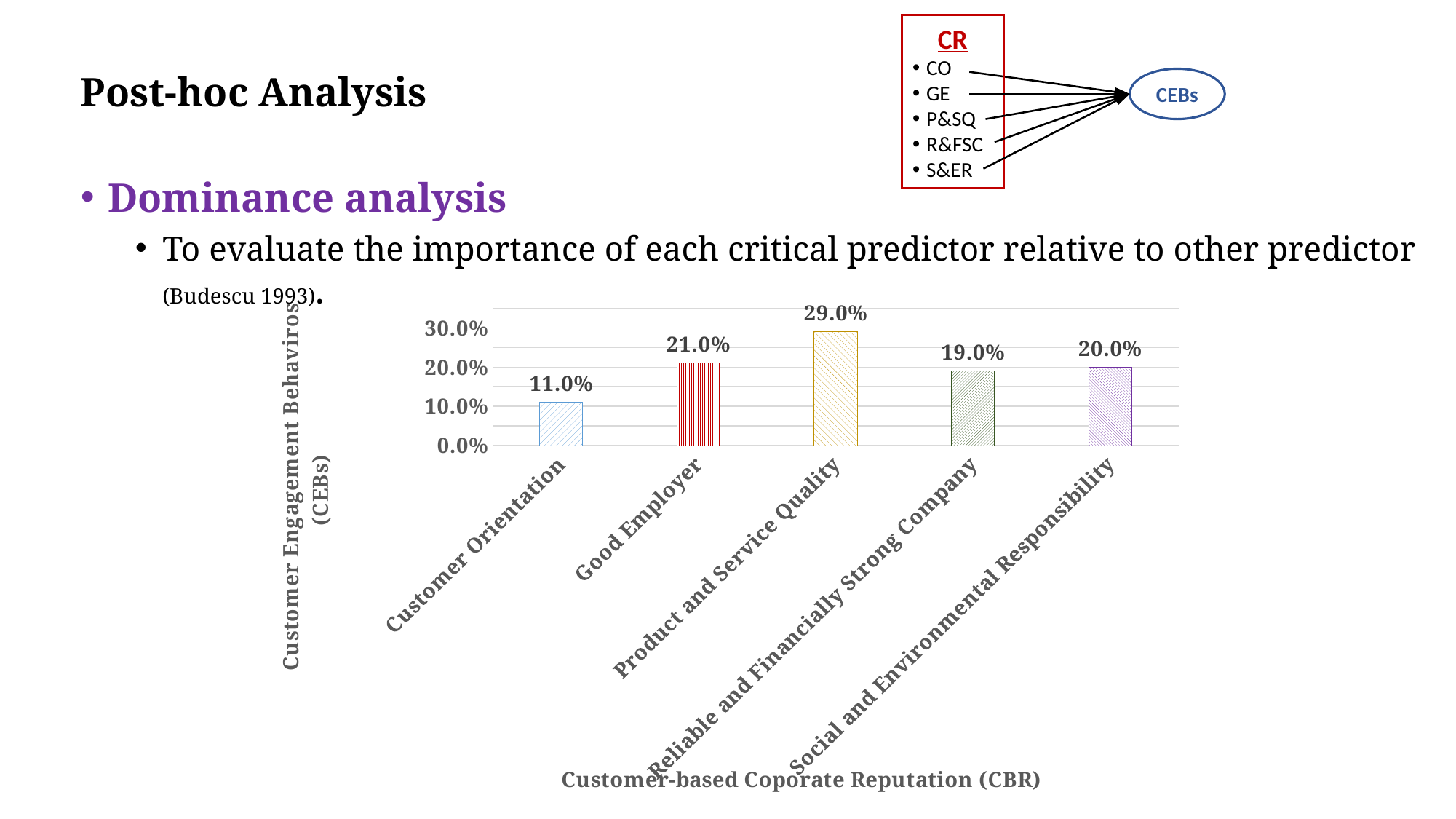
What kind of chart is shown on the slide? bar chart What is the value for Customer Orientation? 11.0% Which is larger, the value for Good Employer or the value for Social and Environmental Responsibility? Good Employer Which category has the highest value? Product and Service Quality Which category has the lowest value? Customer Orientation What is the value for Reliable and Financially Strong Company? 19.0% What is the difference between the values for Product and Service Quality and Good Employer? 8.0% What is the value for Social and Environmental Responsibility? 20.0% How many categories are shown on the x axis? 5 What is the value for Product and Service Quality? 29.0% What is the x-axis title of the chart? Customer-based Coporate Reputation (CBR) Is the value for Customer Orientation greater or less than 20.0%? less